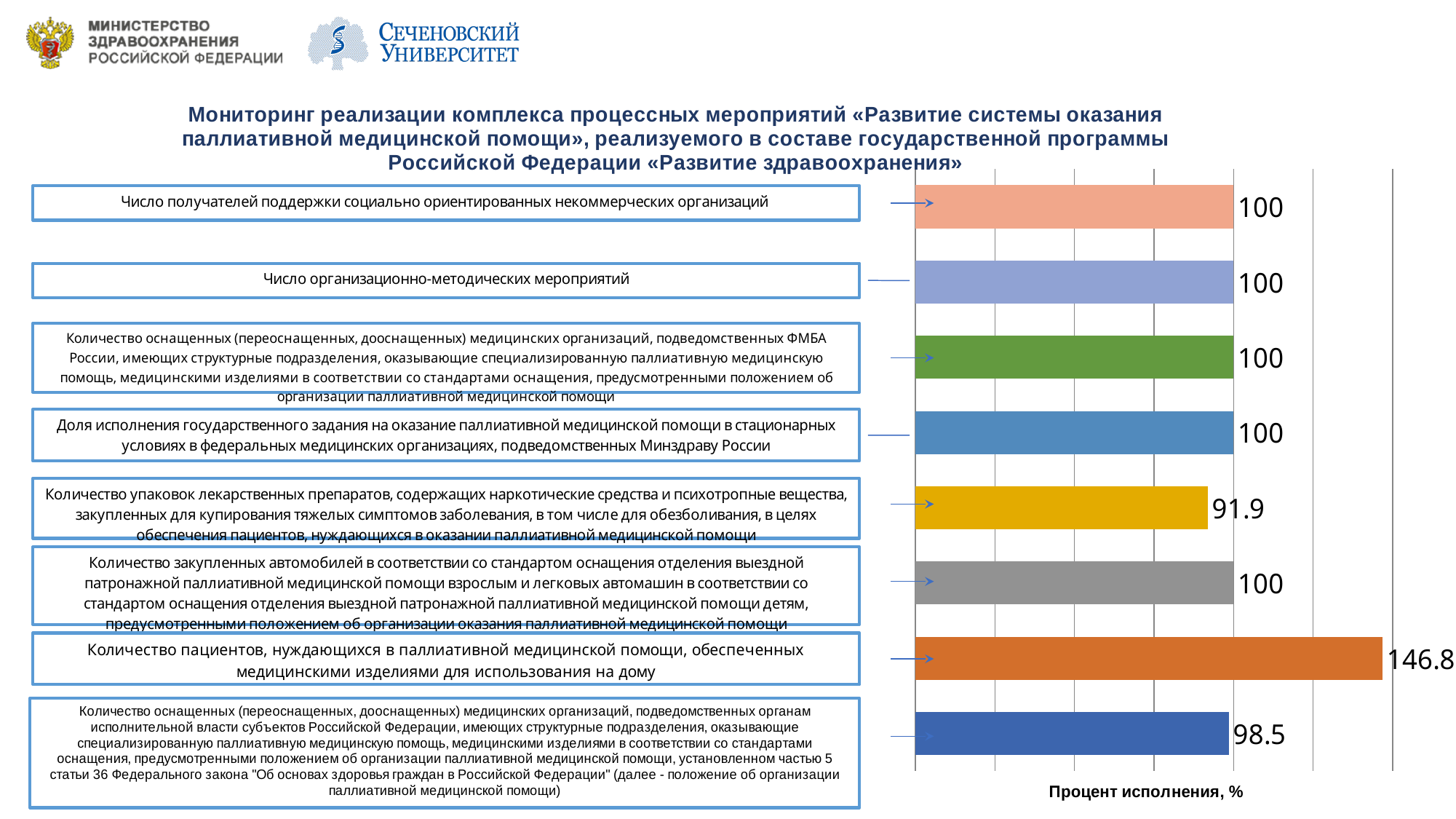
What is the value for «Число организационно-методических мероприятий»? 100 What kind of chart is shown on the slide? bar chart Which category has the highest value? Количество пациентов, нуждающихся в паллиативной медицинской помощи, обеспеченных медицинскими изделиями для использования на дому What is the difference between the value for «Количество пациентов, нуждающихся в паллиативной медицинской помощи...» (146.8) and the value for «Число получателей поддержки социально ориентированных некоммерческих организаций» (100)? 46.8 What is the axis label shown below the chart? Процент исполнения, % What is the value for «Количество упаковок лекарственных препаратов, содержащих наркотические средства и психотропные вещества...»? 91.9 What is the value for «Количество пациентов, нуждающихся в паллиативной медицинской помощи, обеспеченных медицинскими изделиями для использования на дому»? 146.8 How many bars (categories) does the chart show? 8 Which is larger: the value for «Количество упаковок лекарственных препаратов...» or the value for «Количество оснащенных ... медицинских организаций, подведомственных органам исполнительной власти субъектов Российской Федерации...»? Количество оснащенных ... медицинских организаций, подведомственных органам исполнительной власти субъектов Российской Федерации (98.5) How many categories have a value of exactly 100? 5 What is the value for «Количество оснащенных (переоснащенных, дооснащенных) медицинских организаций, подведомственных органам исполнительной власти субъектов Российской Федерации...»? 98.5 Which category has the lowest value? Количество упаковок лекарственных препаратов, содержащих наркотические средства и психотропные вещества...